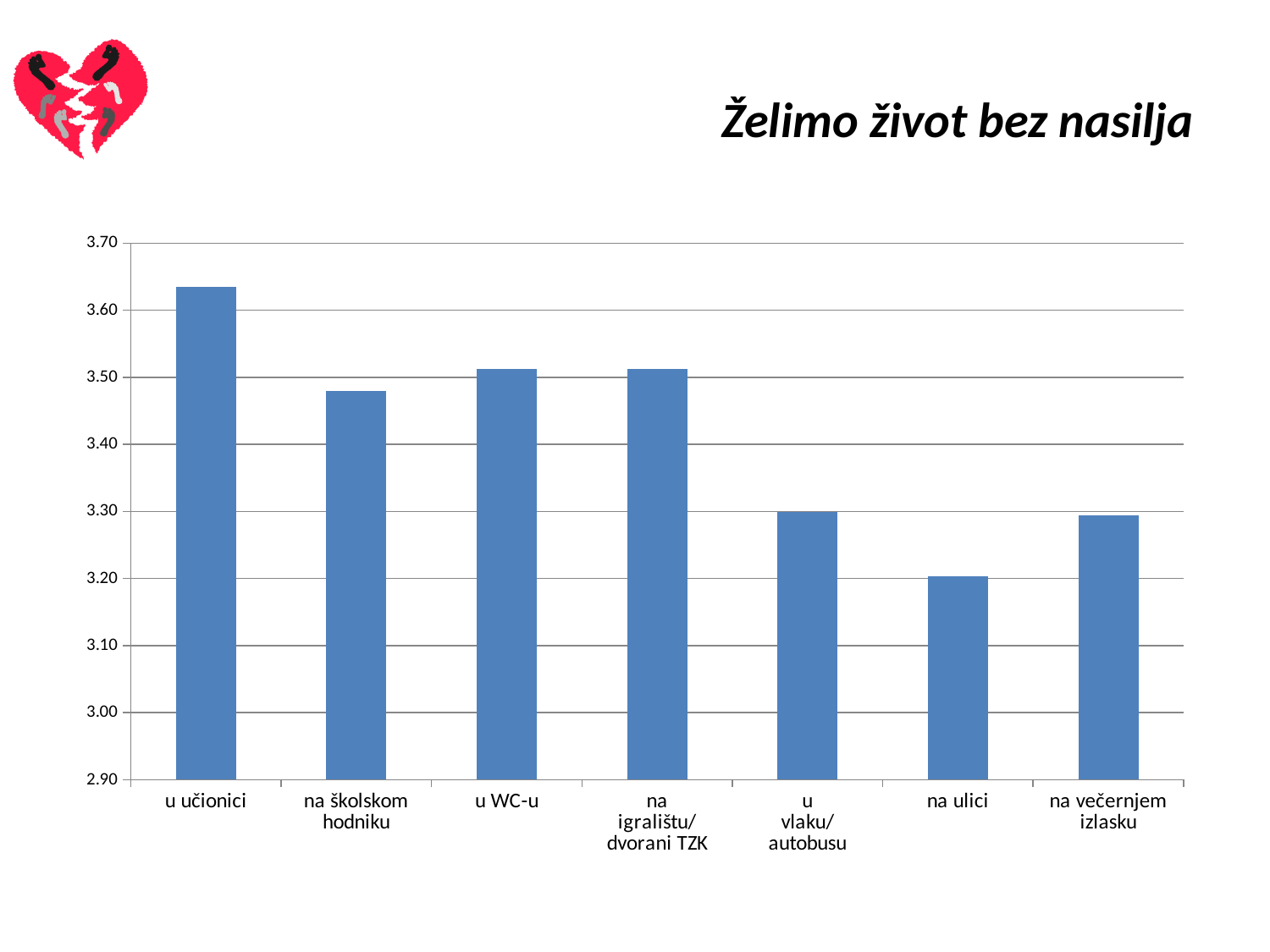
Is the value for u WC-u greater or less than 3.40? greater Is the value for na školskom hodniku greater or less than 3.50? less Which is larger, the value for na školskom hodniku or the value for u vlaku/autobusu? na školskom hodniku Is the value for u učionici greater or less than 3.60? greater How many categories are shown on the x axis of the chart? 7 Which category has the lowest bar in the chart? na ulici What kind of chart is shown on the slide? bar chart Which category has the highest bar in the chart? u učionici Which is larger, the value for u učionici or the value for na ulici? u učionici